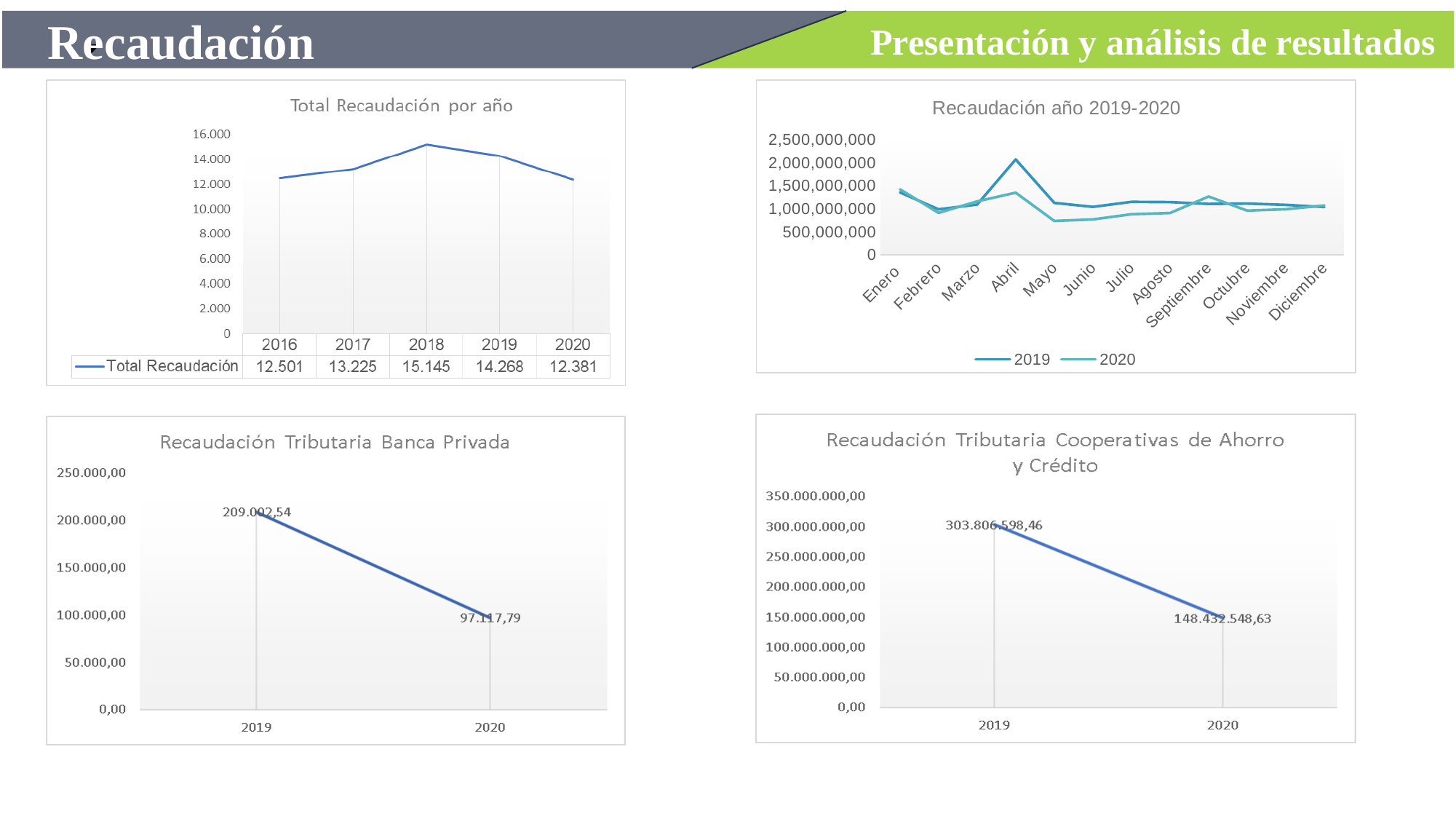
How many years are plotted in the 'Total Recaudación por año' chart? 5 In the 'Recaudación Tributaria Cooperativas de Ahorro y Crédito' chart, what is the value for 2019? 303.806.598,46 In the 'Recaudación año 2019-2020' chart, is the 2020 value for Mayo greater or less than 1,000,000,000? less In the 'Recaudación año 2019-2020' chart, is the 2019 value for Abril greater or less than 2,000,000,000? greater In the 'Recaudación Tributaria Cooperativas de Ahorro y Crédito' chart, do the values rise or fall from 2019 to 2020? fall In the 'Recaudación Tributaria Banca Privada' chart, what is the value for 2020? 97.117,79 In the 'Total Recaudación por año' chart, which year has the highest total? 2018 In the 'Total Recaudación por año' chart, what is the value for 2018? 15.145 How many series does the legend of the 'Recaudación año 2019-2020' chart list? 2 What kind of chart is 'Recaudación Tributaria Banca Privada'? line chart In the 'Total Recaudación por año' chart, which year has the lowest total? 2020 In the 'Total Recaudación por año' chart, what is the difference between the 2018 and 2016 values? 2.644